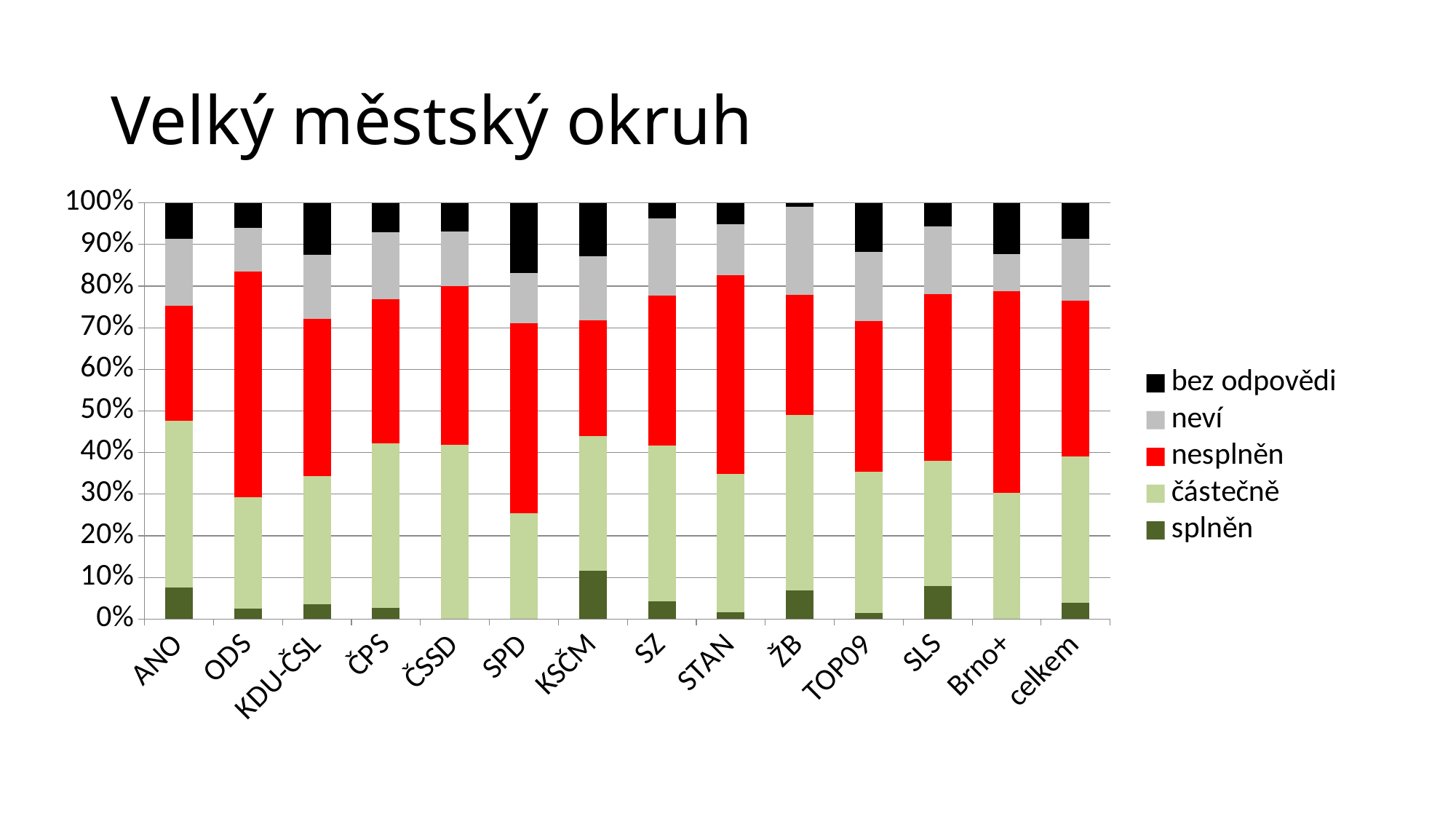
How many series does the legend list? 5 Which category has the largest splněn share? KSČM Is the splněn value for ANO greater or less than 10%? less What kind of chart is shown on the slide? stacked bar chart Which legend entry is shown in red? nesplněn Which category has the largest bez odpovědi share? SPD How many categories are shown along the x axis of the chart? 14 Which category has the smallest bez odpovědi share? ŽB Which category has the largest nesplněn share? ODS Which has a larger nesplněn share, ODS or ANO? ODS Is the splněn value for KSČM greater or less than 10%? greater What is the title of the slide? Velký městský okruh